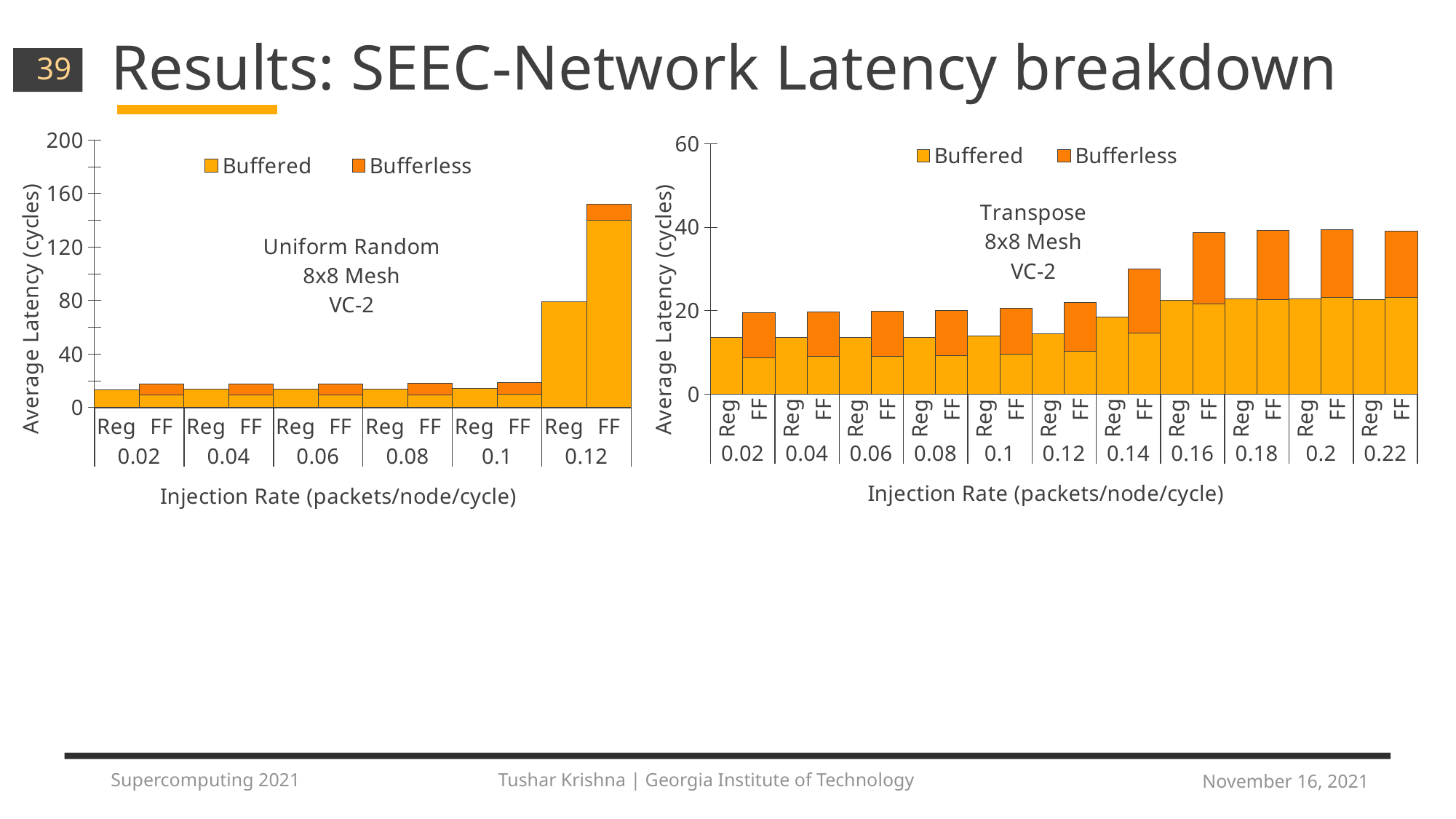
What kind of chart is the Uniform Random chart on the left? stacked bar chart How many series does the legend of the Transpose chart on the right list? 2 In the Uniform Random chart on the left, is the latency of the Reg bar at injection rate 0.02 greater or less than 40? less In the Transpose chart on the right, how many injection rate values are shown on the x axis? 11 What are the two legend entries in the Transpose chart on the right? Buffered and Bufferless In the Transpose chart on the right, is the total latency of the FF bar at injection rate 0.22 greater or less than 20? greater In the Uniform Random chart on the left, which bar reaches the highest total average latency? FF at 0.12 In the Uniform Random chart on the left, how many injection rate values are shown on the x axis? 6 In the Uniform Random chart on the left, which is larger: the total latency of the FF bar at 0.12 or the Reg bar at 0.12? FF at 0.12 In the Transpose chart on the right, is the latency of the Reg bar at injection rate 0.02 greater or less than 20? less In the Transpose chart on the right, do the Reg bars rise or fall as the injection rate increases? rise